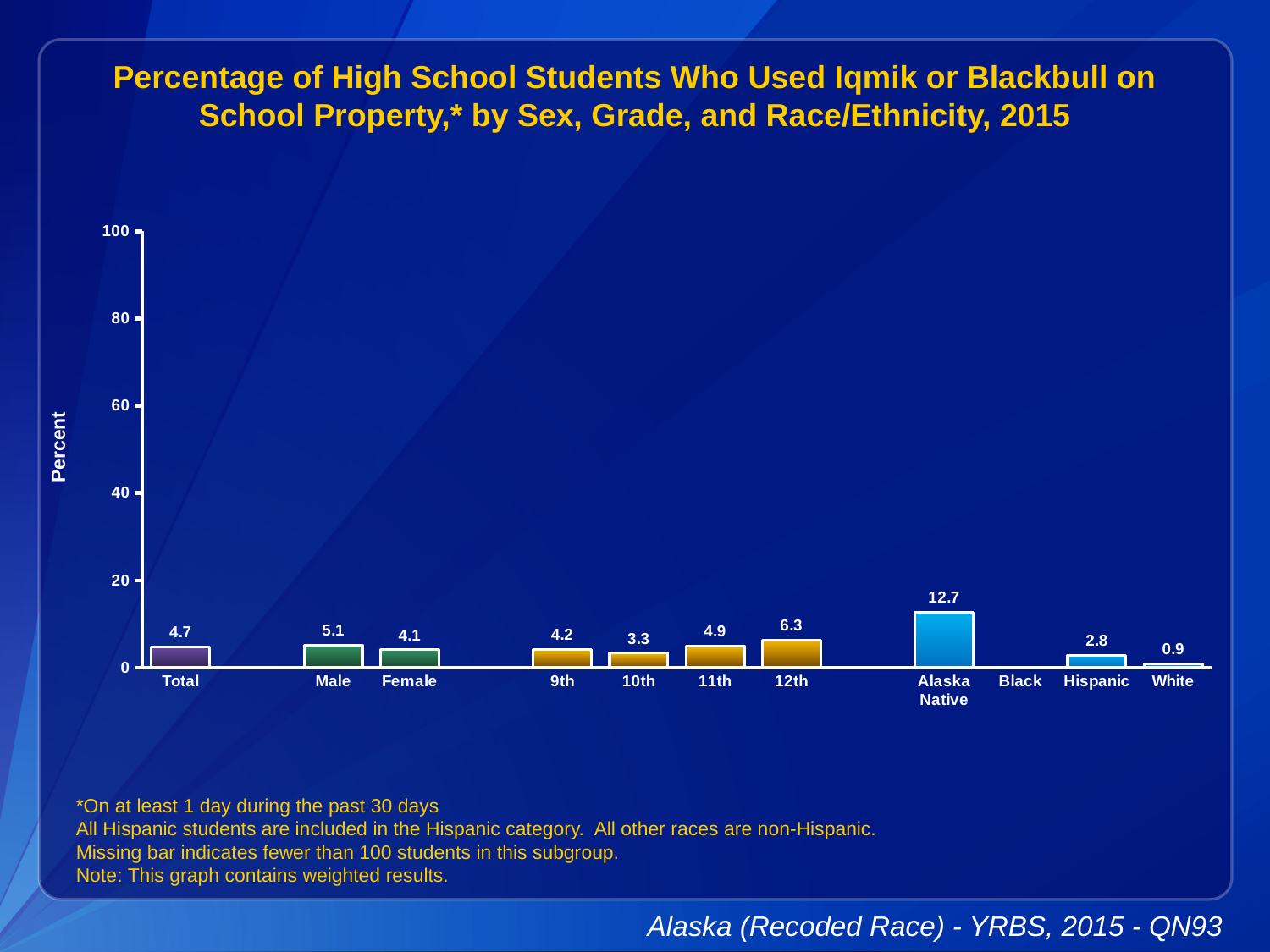
Which category with a plotted bar has the lowest value? White What is the value for 10th grade? 3.3 What is the difference between the Male and Female values? 1.0 What kind of chart is shown? bar chart Which is larger, the value for 12th grade or the value for 9th grade? 12th What is the value for Total? 4.7 How many categories are labeled on the x axis? 11 Which category has the highest value? Alaska Native Which category has no bar plotted? Black What is the value for Alaska Native? 12.7 Do the values rise or fall from 10th grade to 12th grade? rise Is the value for Alaska Native greater or less than 20? less